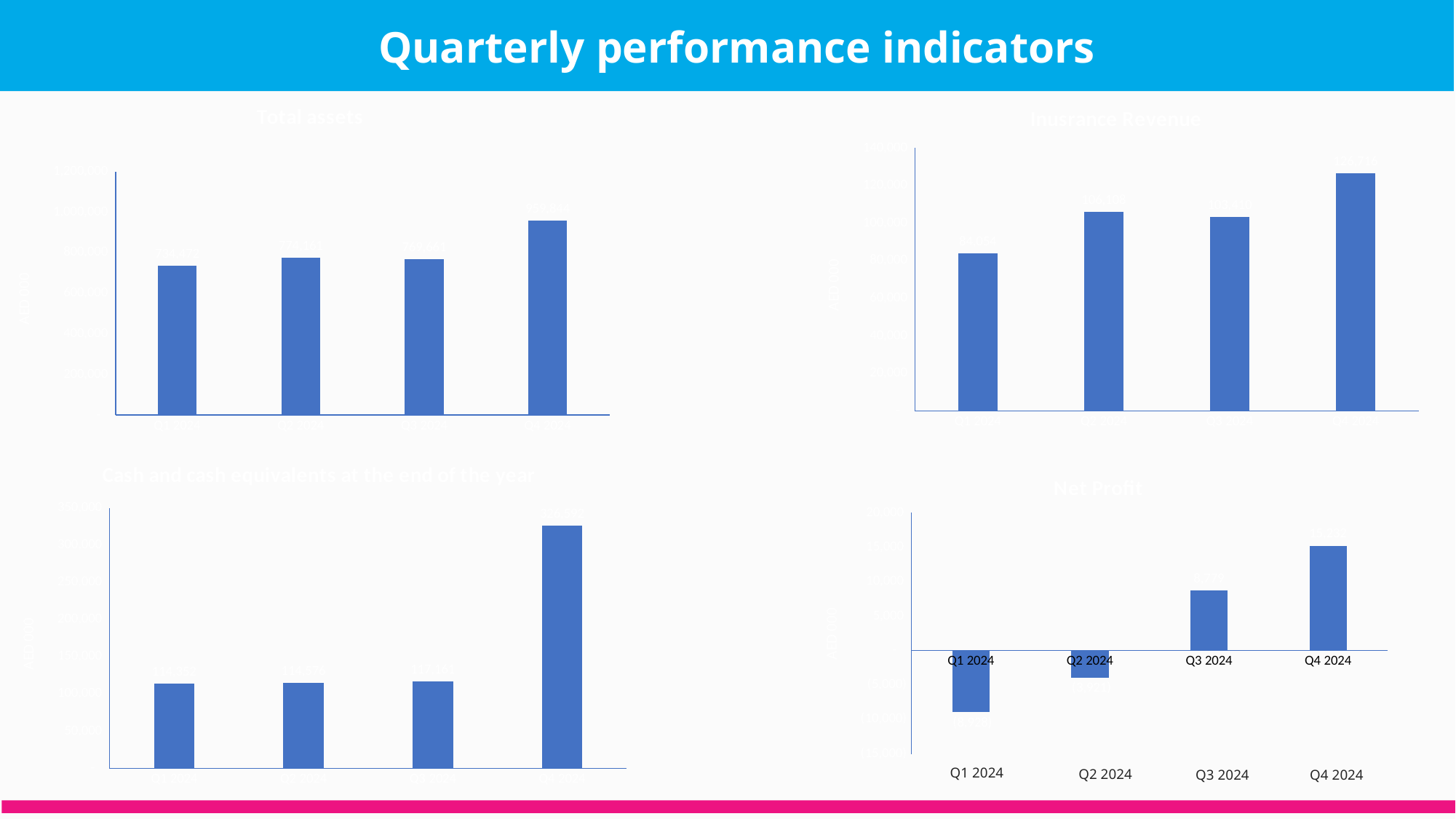
In the bottom-right chart, which quarter has the lowest value? Q1 2024 In the bottom-right chart, which quarter has the highest value? Q4 2024 How many charts are shown on the slide? 4 In the top-right chart, which is taller, the second bar or the third bar? The second bar In the bottom-right chart, do the values generally rise or fall from Q1 2024 to Q4 2024? Rise What kind of chart is the bottom-right chart on the slide? Bar chart In the top-left chart, which bar is the tallest? The fourth (rightmost) bar In the bottom-right chart, is the value for Q1 2024 greater or less than 0? less In the bottom-right chart, is the value for Q3 2024 greater or less than 0? greater In the bottom-right chart, which is larger, the value for Q3 2024 or Q4 2024? Q4 2024 In the bottom-right chart, how many quarters are plotted? 4 In the top-right chart, which bar is the shortest? The first (leftmost) bar